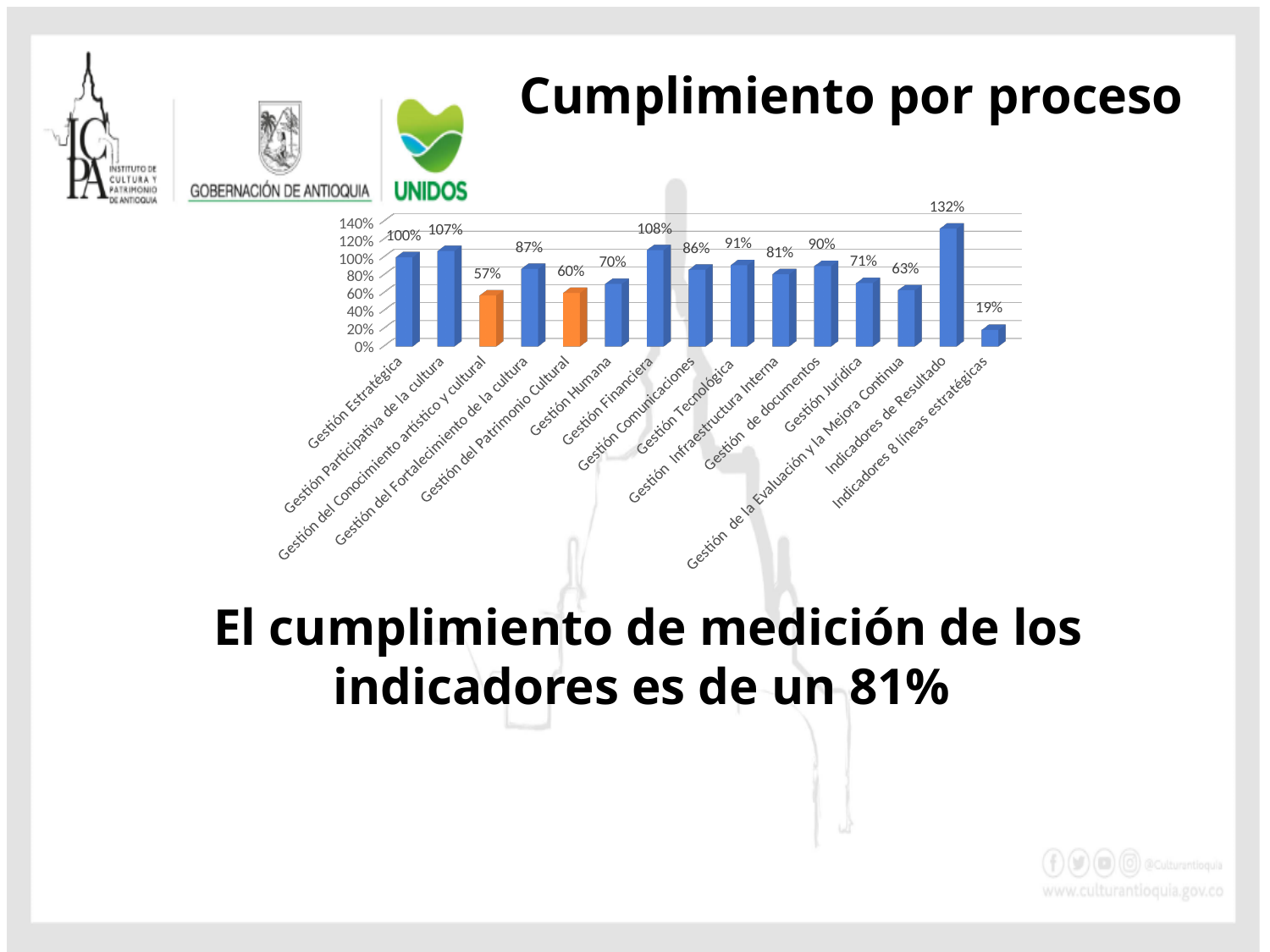
Is the value for Gestión Humana greater or less than 80%? less What is the value for Gestión de la Evaluación y la Mejora Continua? 63% Which is larger, the value for Gestión Tecnológica or the value for Gestión Comunicaciones? Gestión Tecnológica How many categories are shown on the x axis? 15 Which category has the highest value? Indicadores de Resultado Which two categories are shown with orange bars instead of blue? Gestión del Conocimiento artístico y cultural and Gestión del Patrimonio Cultural What is the difference between the values for Indicadores de Resultado and Indicadores 8 líneas estratégicas? 113% Which category has the lowest value? Indicadores 8 líneas estratégicas What is the value for Gestión Financiera? 108% What is the value for Gestión del Patrimonio Cultural? 60% What kind of chart is shown on the slide? bar chart What is the value for Gestión Estratégica? 100%